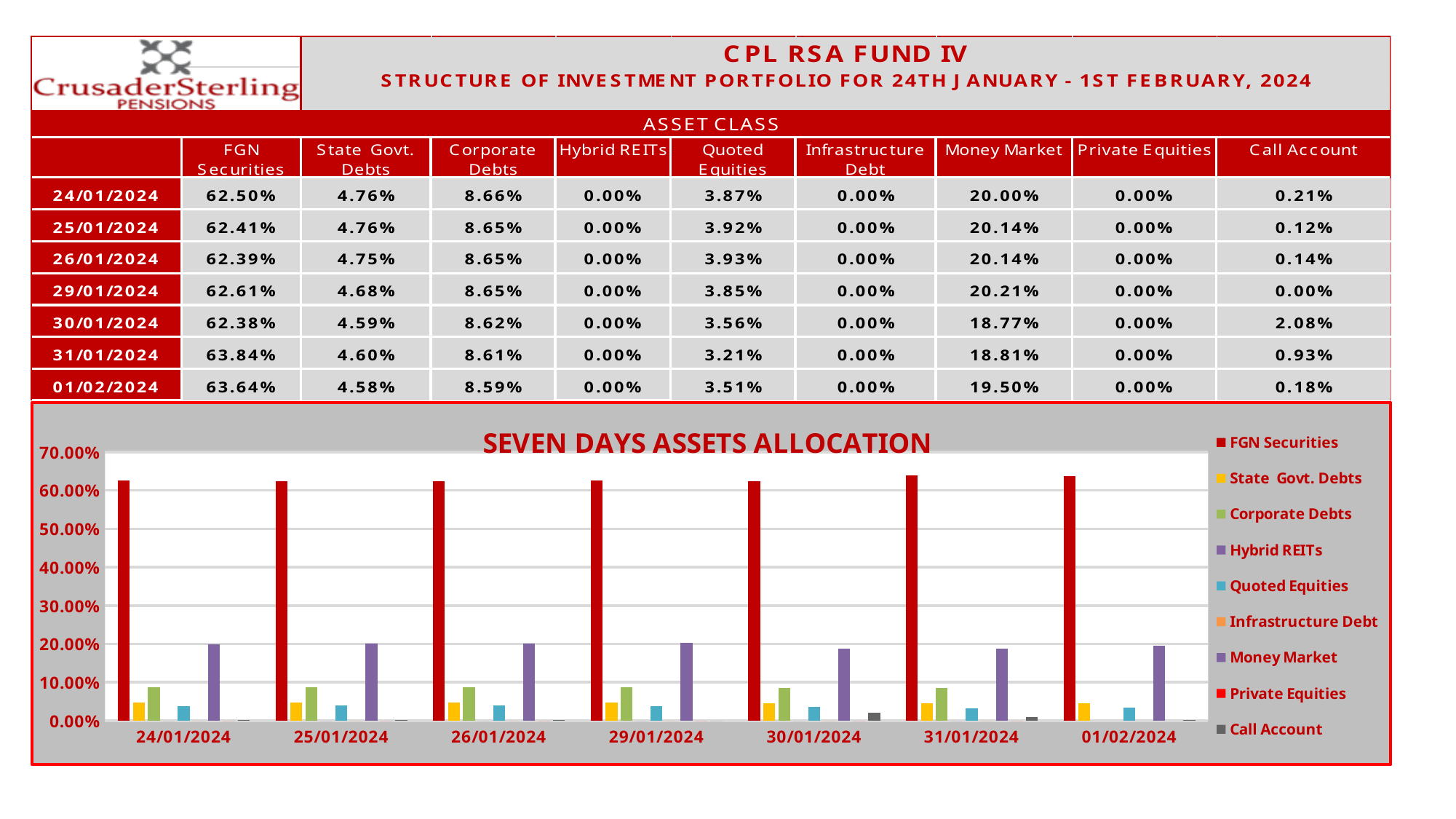
In the chart, is the value for FGN Securities on 24/01/2024 greater or less than 60.00%? greater What is the FGN Securities allocation on 31/01/2024? 63.84% What kind of chart is shown under the title 'SEVEN DAYS ASSETS ALLOCATION'? Bar chart In the chart, is the value for Money Market on 30/01/2024 greater or less than 20.00%? less How many dates are shown along the x axis of the 'SEVEN DAYS ASSETS ALLOCATION' chart? 7 On 24/01/2024, which is larger: Corporate Debts or State Govt. Debts? Corporate Debts Which asset class has the tallest bar on every date in the chart? FGN Securities What is the Money Market allocation on 29/01/2024? 20.21% How many series does the legend of the 'SEVEN DAYS ASSETS ALLOCATION' chart list? 9 What is the difference between the FGN Securities allocation on 31/01/2024 and on 24/01/2024? 1.34% What is the Call Account allocation on 30/01/2024? 2.08% What is the title of the chart on the slide? SEVEN DAYS ASSETS ALLOCATION